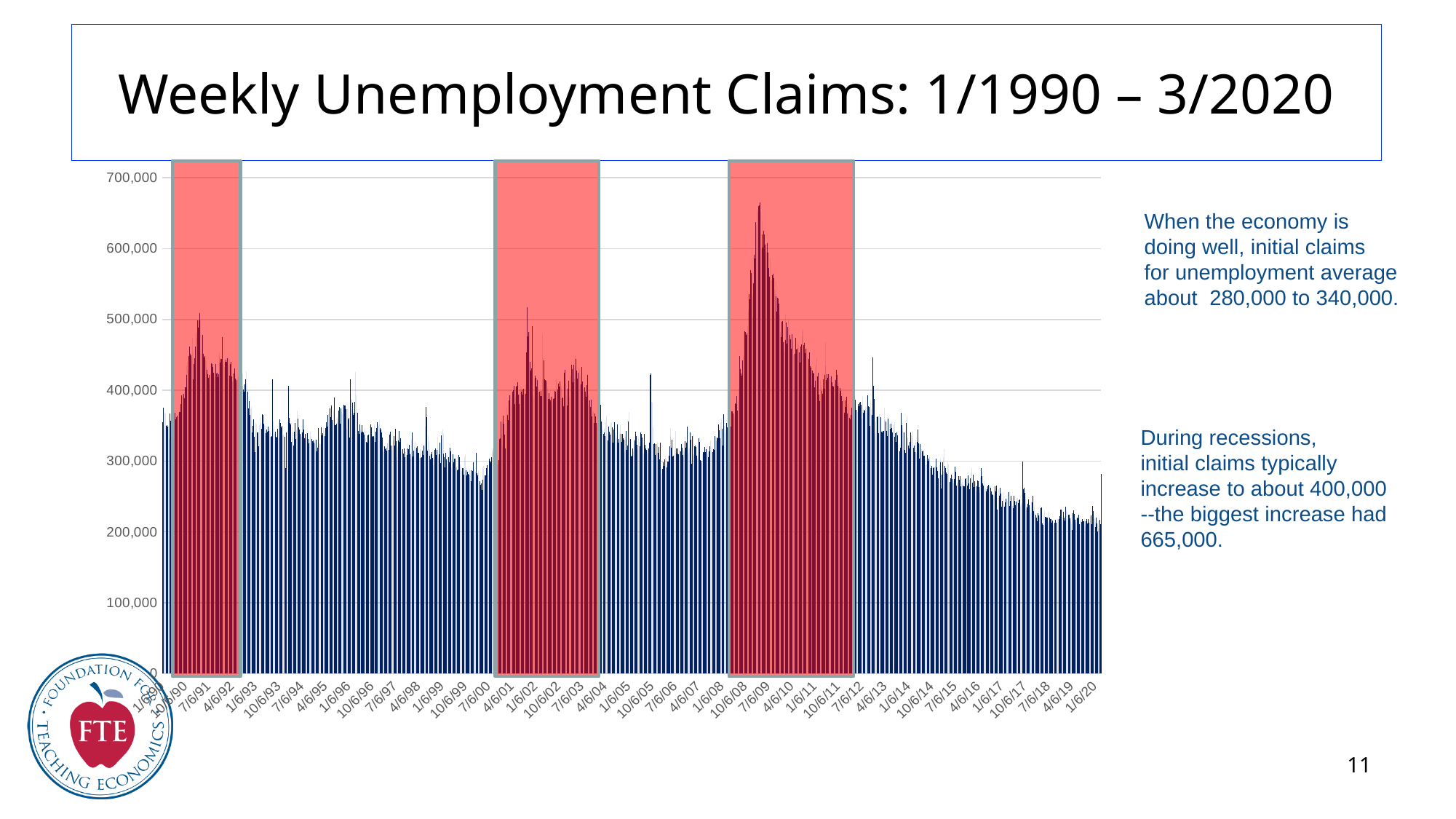
Is the value for 10/6/99 greater or less than 400,000? less Which of the three shaded recession periods contains the highest peak in weekly claims? the third (2008–2011) What is the title of the chart? Weekly Unemployment Claims: 1/1990 – 3/2020 How many red shaded recession periods are highlighted on the chart? 3 Is the value for 1/6/17 greater or less than 300,000? less Is the highest value on the chart greater or less than 600,000? greater What kind of chart is shown on the slide? bar chart What is the highest tick value shown on the vertical axis? 700,000 Which is larger, the value for 7/6/09 or the value for 7/6/02? 7/6/09 Do the values generally rise or fall from 7/6/12 to 1/6/20? fall